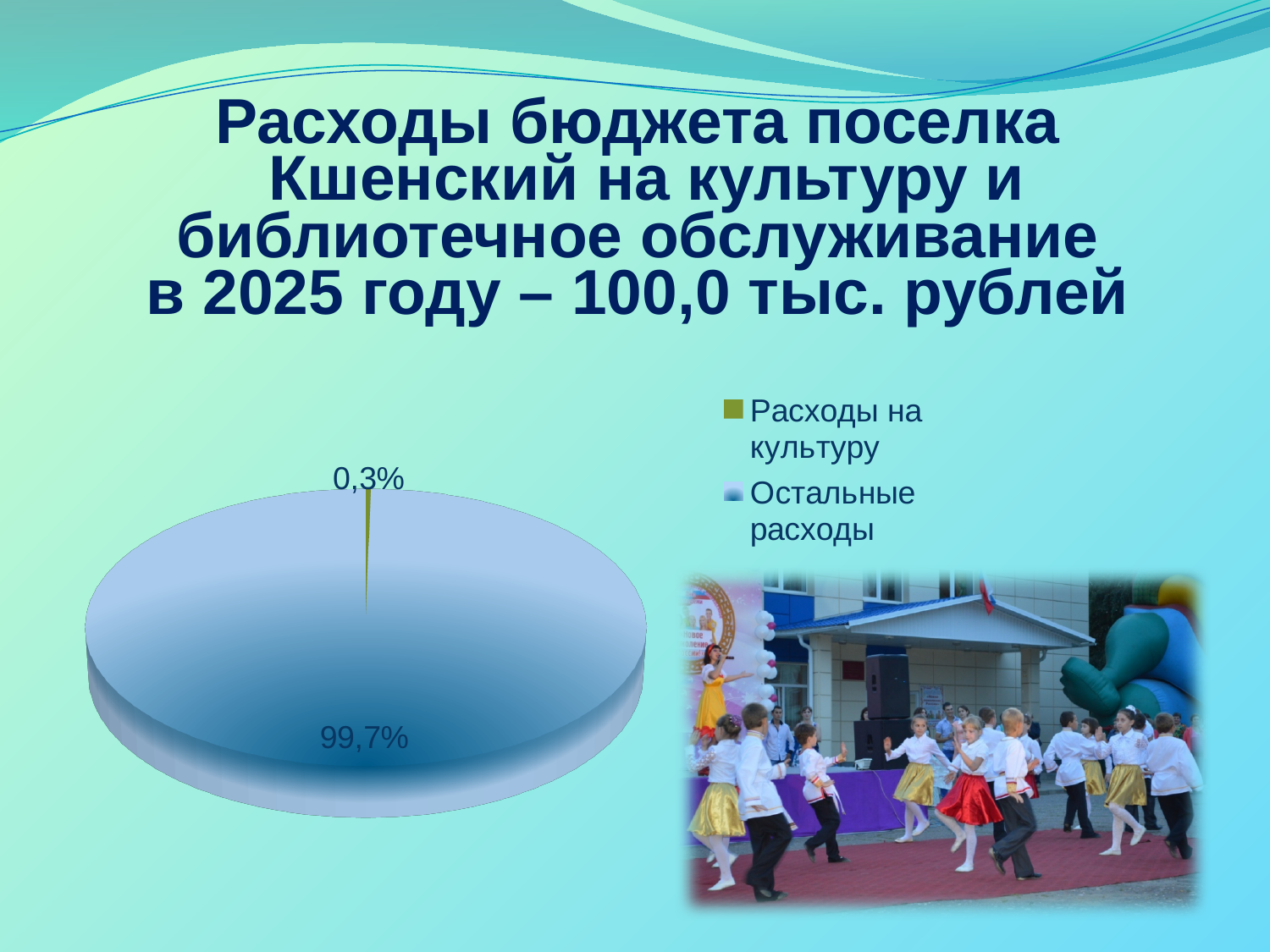
What share of the pie does "Расходы на культуру" represent? 0,3% Which slice of the pie is the largest? Остальные расходы According to the slide title, what is the total amount of budget expenditure on culture and library services in 2025? 100,0 тыс. рублей How many slices does the pie chart have? 2 What kind of chart is shown on the slide? pie chart What share of the pie does "Остальные расходы" represent? 99,7% Which slice of the pie is the smallest? Расходы на культуру How many entries does the legend list? 2 What colour is the "Расходы на культуру" slice in the legend? olive/yellow-green What is the difference in percentage points between the "Остальные расходы" slice and the "Расходы на культуру" slice? 99,4 Which is larger: the share for "Расходы на культуру" or the share for "Остальные расходы"? Остальные расходы